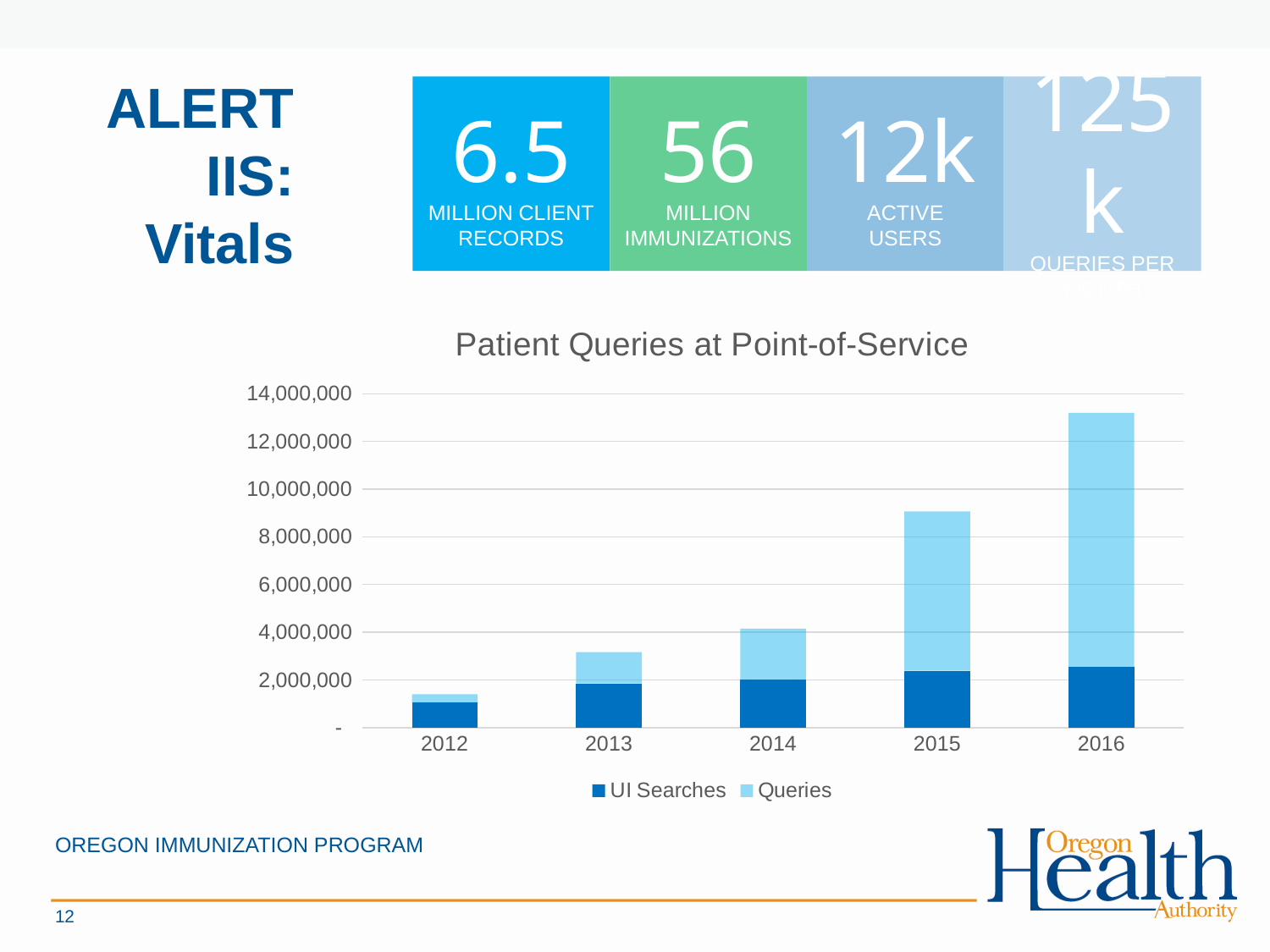
Is the total bar height for 2015 greater or less than 8,000,000? greater Is the total bar height for 2012 greater or less than 2,000,000? less Which year has the tallest stacked bar in the chart? 2016 What type of chart is shown under the title "Patient Queries at Point-of-Service"? Stacked bar chart Which year has a larger total bar, 2014 or 2015? 2015 Is the total bar height for 2014 greater or less than 6,000,000? less How many series does the chart legend list? 2 Do the total bar heights rise or fall from 2012 to 2016? Rise How many years are shown along the x axis of the chart? 5 What is the title of the chart on the slide? Patient Queries at Point-of-Service Which year has the shortest stacked bar in the chart? 2012